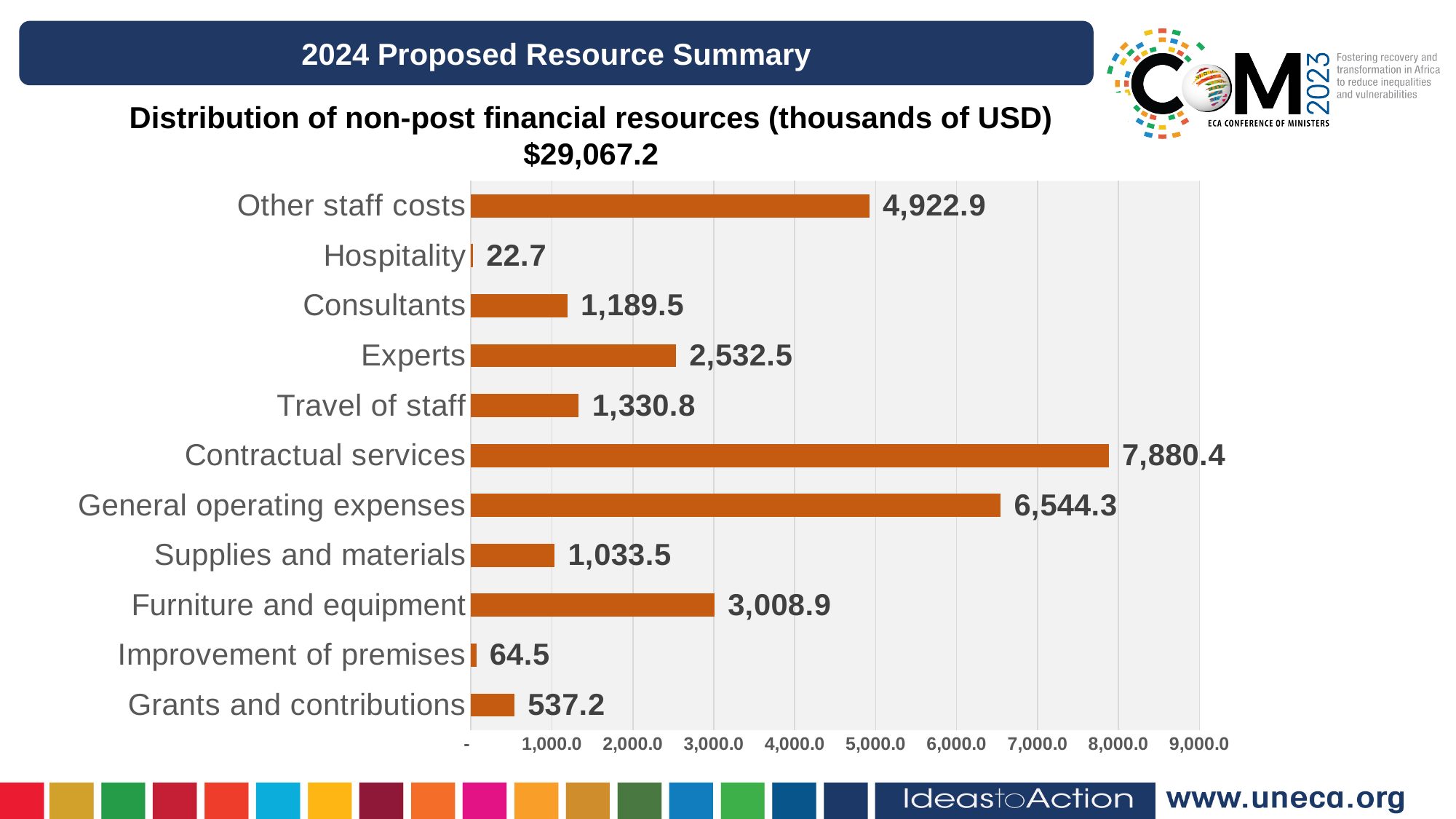
Is the value for Other staff costs greater or less than 4,000.0? greater Which is larger, Experts or Furniture and equipment? Furniture and equipment What is the difference between Contractual services and General operating expenses? 1,336.1 What is the value for Improvement of premises? 64.5 What kind of chart is shown on the slide? bar chart Which category has the highest value? Contractual services Which category has the lowest value? Hospitality What is the difference between Other staff costs and Furniture and equipment? 1,914.0 What is the value for Contractual services? 7,880.4 How many categories are shown in the chart? 11 What is the value for Travel of staff? 1,330.8 What total amount is stated in the chart title? $29,067.2